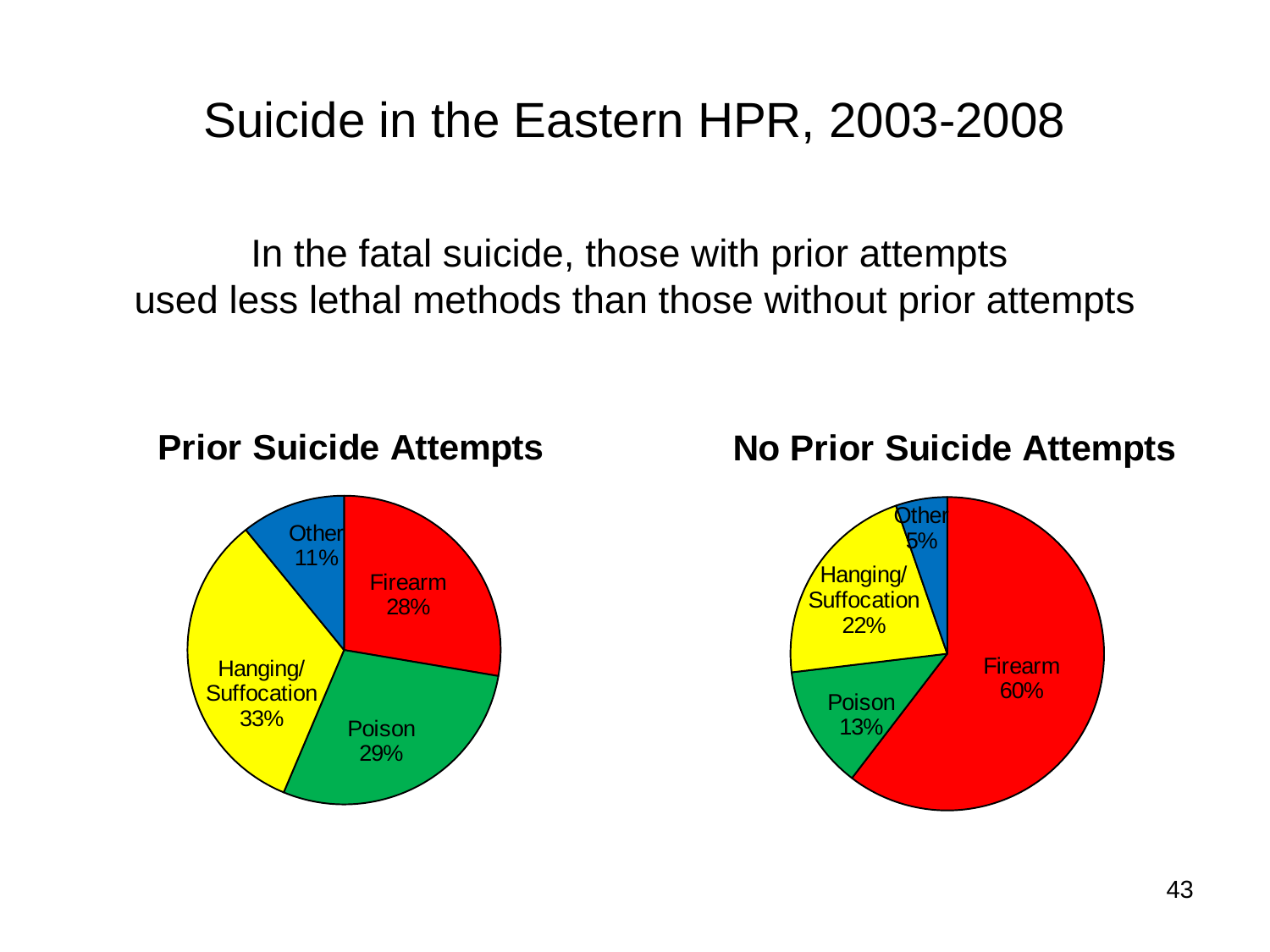
What colour is the Firearm slice in both pie charts? Red In the No Prior Suicide Attempts chart, what is the value for Hanging/Suffocation? 22% In the Prior Suicide Attempts chart, which category has the largest slice? Hanging/Suffocation In the No Prior Suicide Attempts chart, which is larger, Poison or Hanging/Suffocation? Hanging/Suffocation In the Prior Suicide Attempts chart, what share is Hanging/Suffocation? 33% In the No Prior Suicide Attempts chart, which category has the smallest slice? Other What is the difference between the Firearm share in the No Prior Suicide Attempts chart and the Firearm share in the Prior Suicide Attempts chart? 32% In the Prior Suicide Attempts chart, what is the difference between Poison and Other? 18% How many categories does the Prior Suicide Attempts chart show? 4 What kind of chart is the No Prior Suicide Attempts chart? Pie chart In the No Prior Suicide Attempts chart, what share is Firearm? 60% In the Prior Suicide Attempts chart, what is the value for Poison? 29%